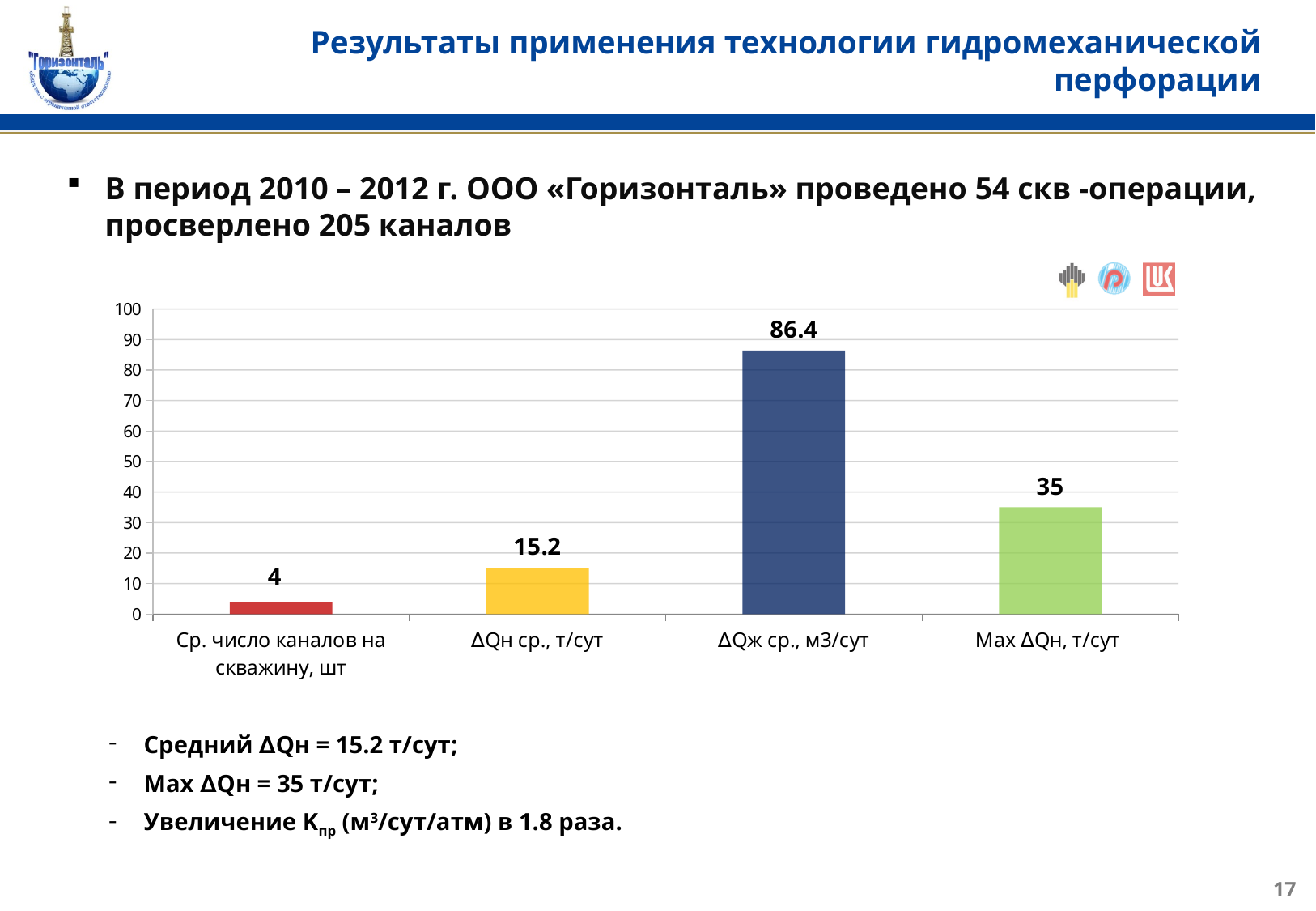
What is the value for 'Max ΔQн, т/сут'? 35 How many categories are shown on the chart? 4 What is the value for 'ΔQж ср., м3/сут'? 86.4 Which category has the highest value? ΔQж ср., м3/сут What is the difference between the values for 'Max ΔQн, т/сут' and 'ΔQн ср., т/сут'? 19.8 What colour is the bar for 'ΔQн ср., т/сут'? yellow What is the value for 'ΔQн ср., т/сут'? 15.2 Is the value for 'ΔQж ср., м3/сут' greater or less than 80? greater Which is larger: the value for 'ΔQж ср., м3/сут' or the value for 'Max ΔQн, т/сут'? ΔQж ср., м3/сут What is the value for 'Ср. число каналов на скважину, шт'? 4 Which category has the lowest value? Ср. число каналов на скважину, шт What kind of chart is shown on the slide? bar chart